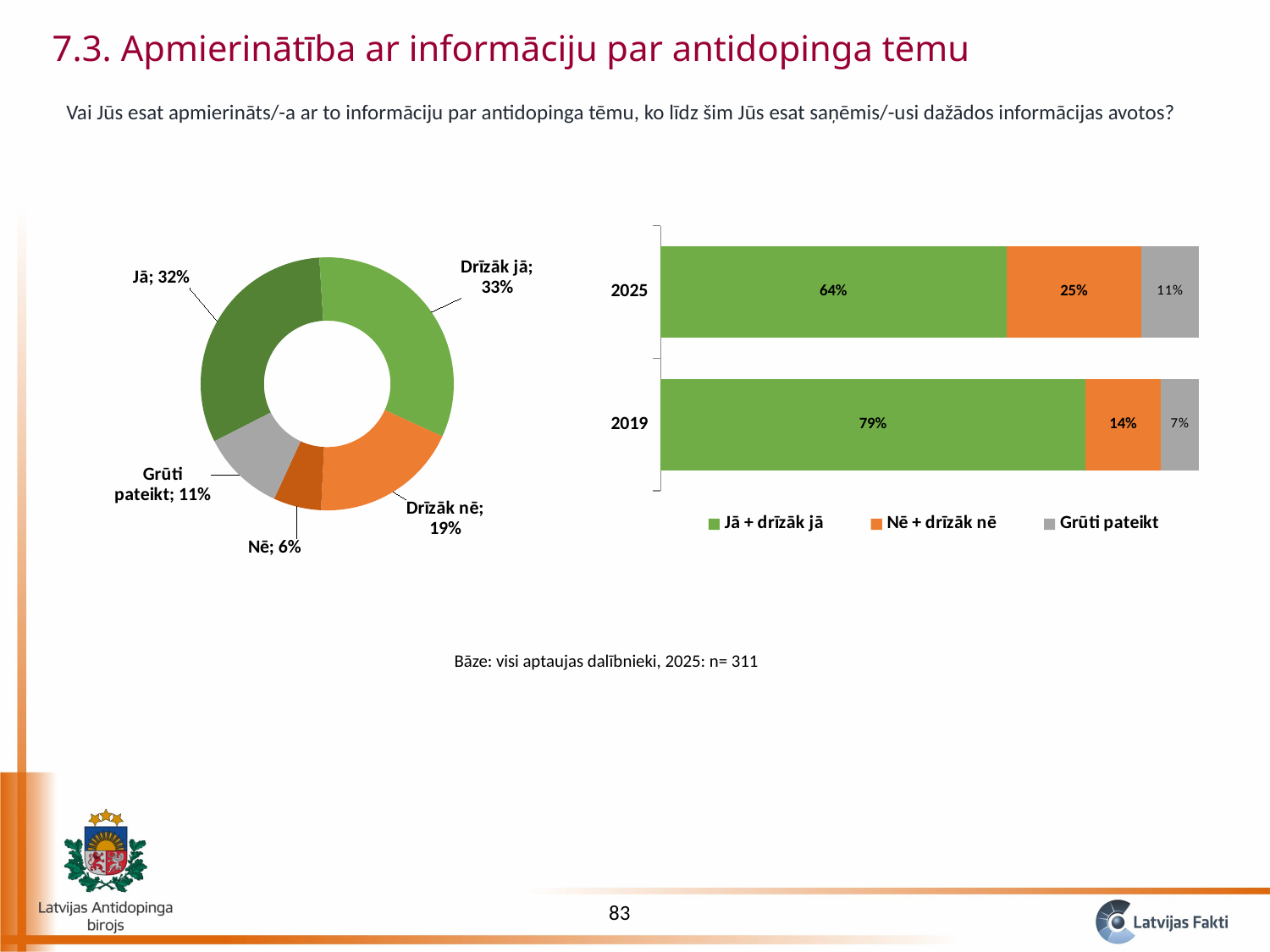
What type of chart is shown on the right side of the slide? Stacked bar chart In the stacked bar chart on the right, how many series does the legend list? 3 In the stacked bar chart on the right, what is the value for "Nē + drīzāk nē" in 2019? 14% In the doughnut chart on the left, what is the difference between the shares for "Jā" and "Grūti pateikt"? 21 percentage points In the doughnut chart on the left, how many categories are shown? 5 In the doughnut chart on the left, which category has the largest share? Drīzāk jā In the stacked bar chart on the right, what is the value for "Jā + drīzāk jā" in 2025? 64% In the doughnut chart on the left, what share is labelled "Jā"? 32% In the doughnut chart on the left, what share is labelled "Drīzāk nē"? 19% In the stacked bar chart on the right, what is the difference between the "Grūti pateikt" values for 2025 and 2019? 4 percentage points In the doughnut chart on the left, which category has the smallest share? Nē In the stacked bar chart on the right, which year has the larger value for "Jā + drīzāk jā", 2025 or 2019? 2019